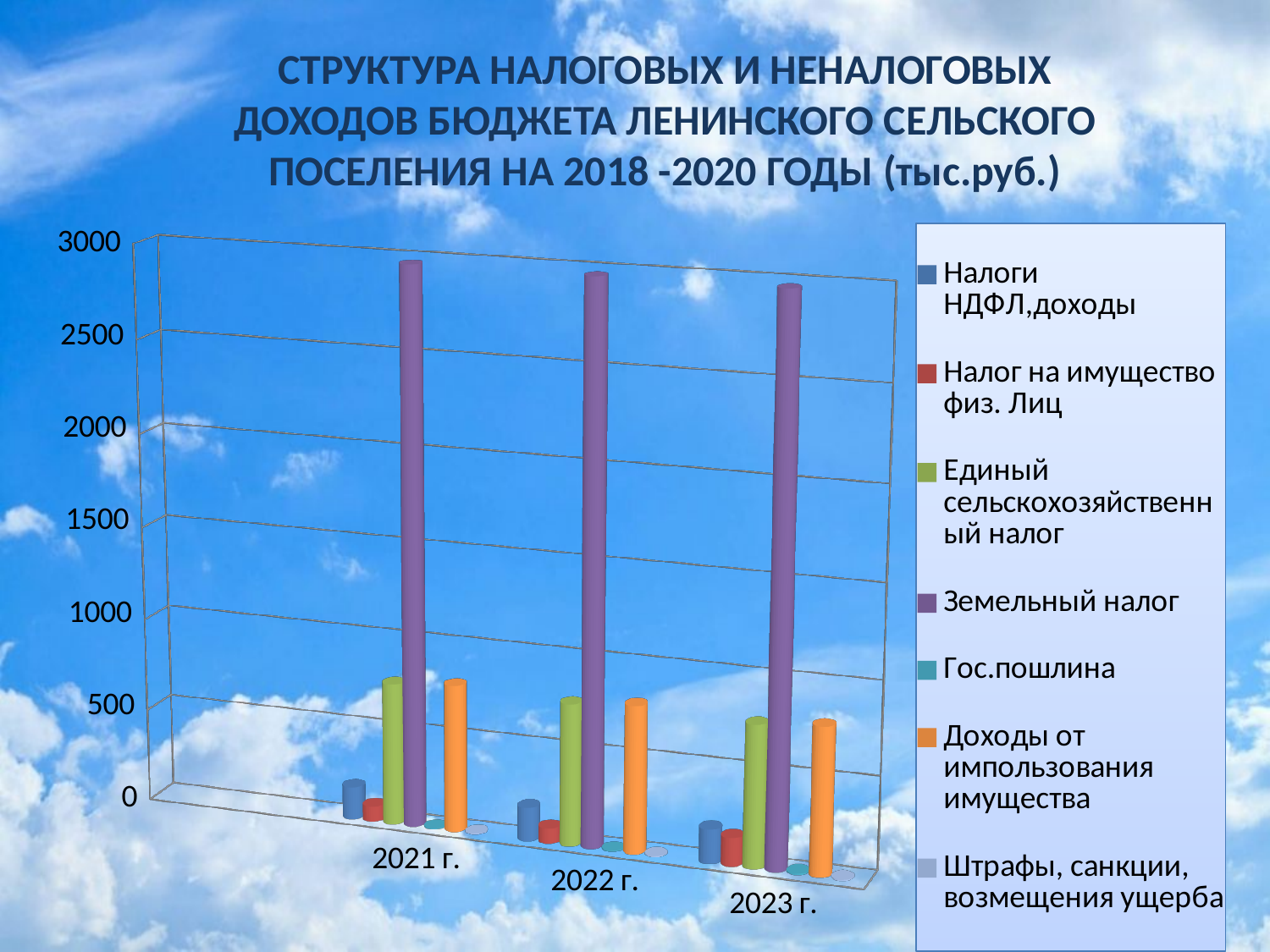
Is the value for Земельный налог in 2021 г. greater or less than 2500? greater How many year categories are shown on the x axis of the chart? 3 Is the value for Единый сельскохозяйственный налог in 2021 г. greater or less than 1000? less What kind of chart is shown on the slide? bar chart Which series has the highest value in 2023 г.? Земельный налог Which series has the highest value in 2021 г.? Земельный налог In 2022 г., which is larger: Земельный налог or Единый сельскохозяйственный налог? Земельный налог What unit of measurement is stated in the chart title? тыс.руб. Is the value for Доходы от импользования имущества in 2023 г. greater or less than 1000? less How many series does the chart's legend list? 7 What colour represents Земельный налог in the legend? purple